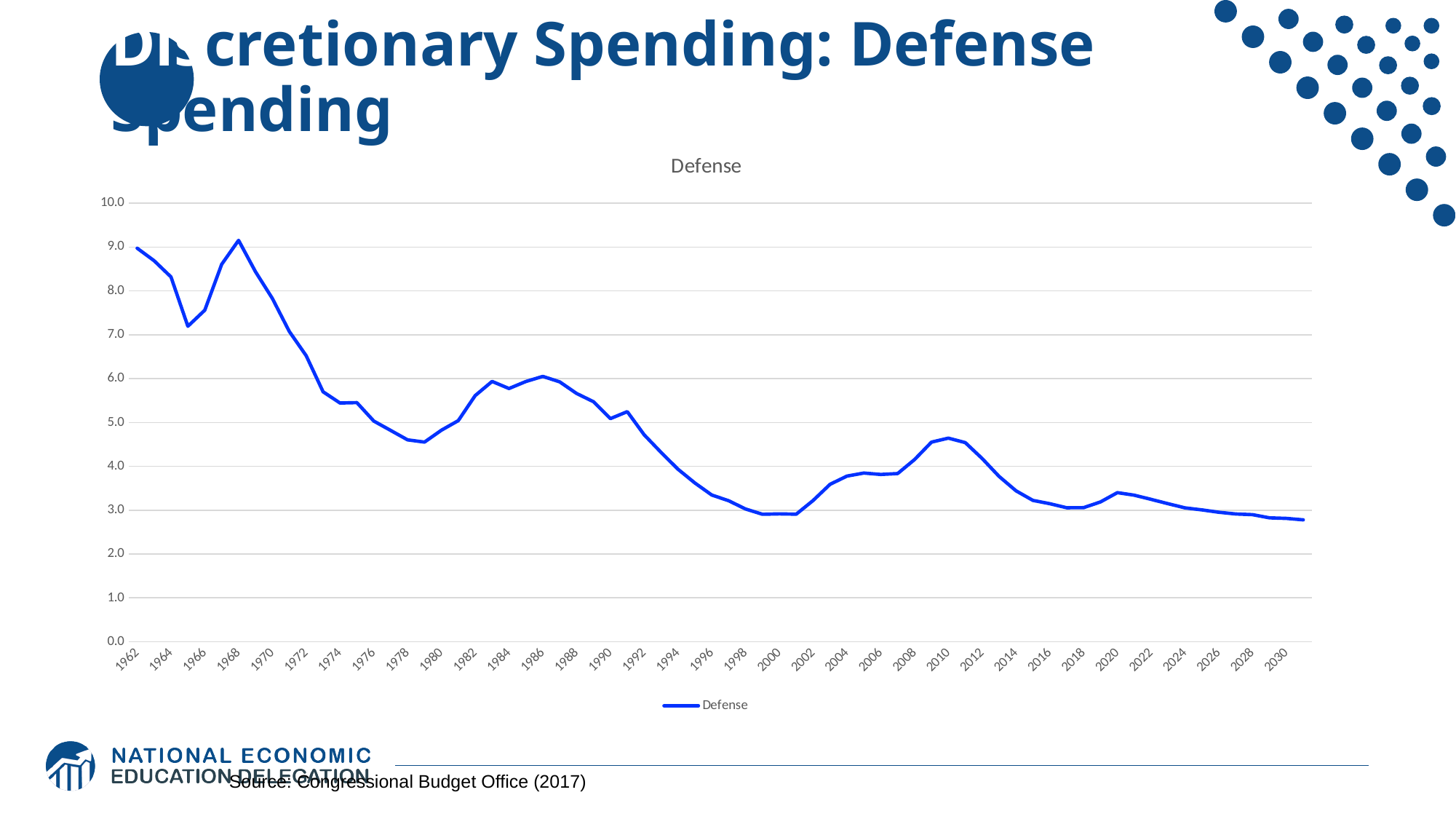
Is the value for 1966 greater or less than 8.0? less Is the value for 2000 greater or less than 4.0? less Is the value for 2010 greater or less than 4.0? greater What kind of chart is shown on the slide? line chart How many series does the legend list? 1 What is the title of the chart? Defense Which year has the higher value, 1962 or 2030? 1962 Overall, does the Defense line rise or fall from 1962 to 2030? fall In which year does the Defense line reach its highest value? 1968 What is the first year shown on the x axis? 1962